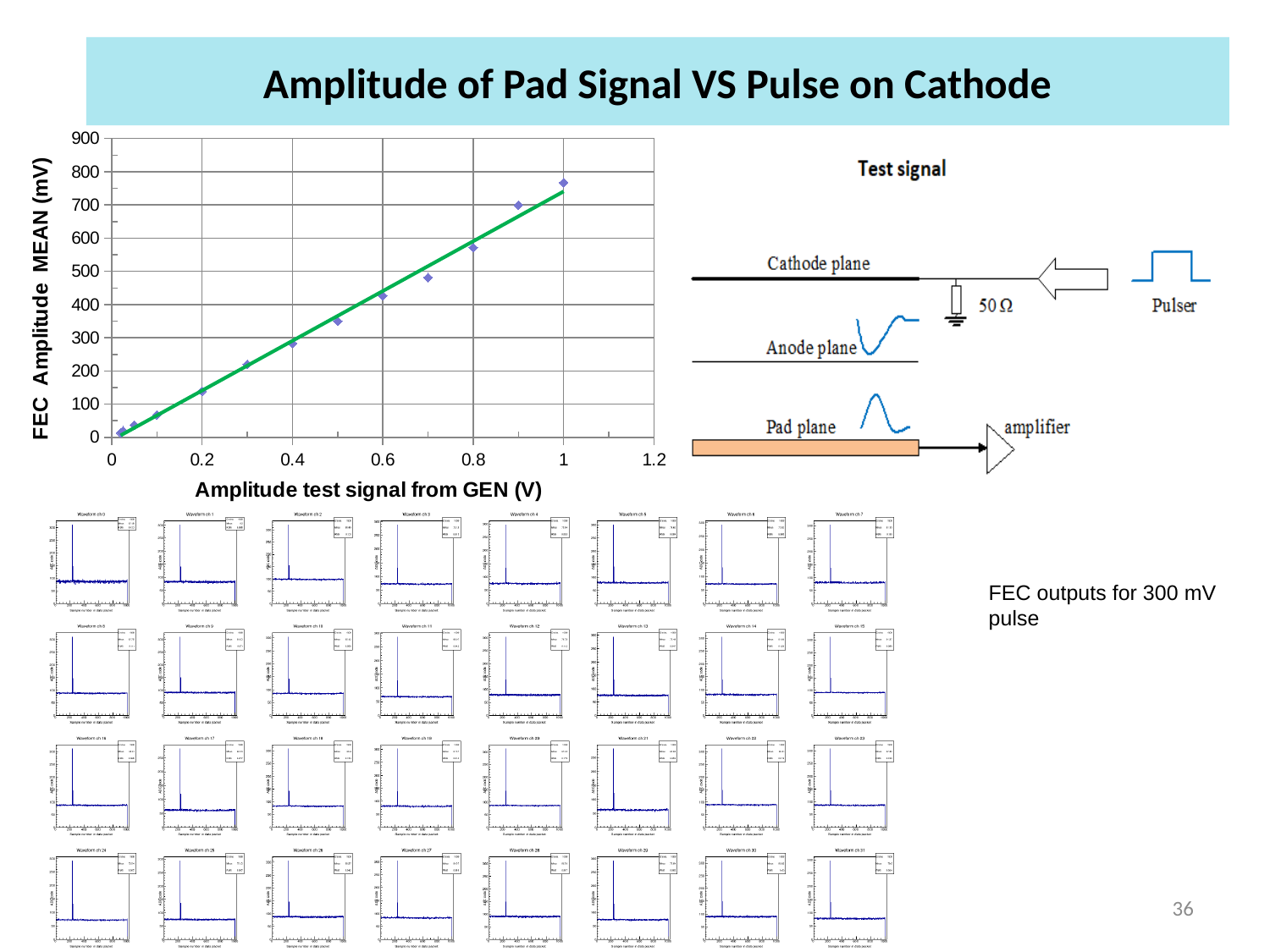
In the scatter chart, at which test signal amplitude is the FEC Amplitude MEAN highest? 1 V In the scatter chart, is the FEC Amplitude MEAN at a test signal of 0.2 V greater or less than 100? greater In the scatter chart, is the FEC Amplitude MEAN at a test signal of 1 V greater or less than 700? greater What kind of chart is the 'Amplitude of Pad Signal VS Pulse on Cathode' chart? scatter chart What is the highest value shown on the y axis of the scatter chart? 900 In the scatter chart, is the FEC Amplitude MEAN at a test signal of 0.5 V greater or less than 400? less What is the label of the y axis of the scatter chart? FEC Amplitude MEAN (mV) What is the label of the x axis of the scatter chart? Amplitude test signal from GEN (V) In the scatter chart, do the FEC amplitude values rise or fall as the test signal amplitude increases along the x axis? rise In the scatter chart, which has the larger FEC Amplitude MEAN: the point at 0.7 V or the point at 0.5 V? 0.7 V